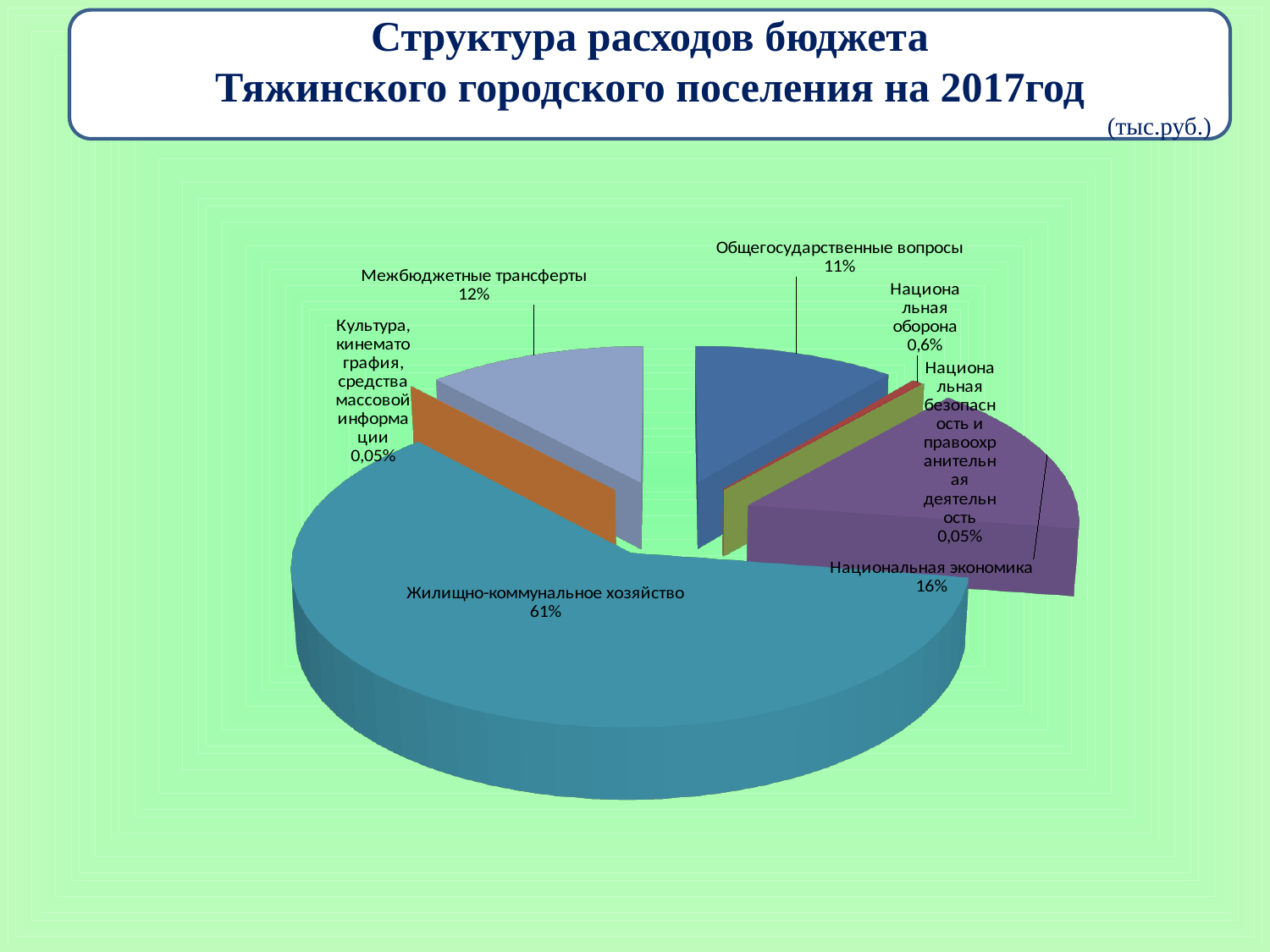
What share of the budget expenditure goes to Жилищно-коммунальное хозяйство? 61% Which category has the largest share of the budget expenditure? Жилищно-коммунальное хозяйство What share of the budget expenditure goes to Межбюджетные трансферты? 12% What is the difference in percentage points between the share for Жилищно-коммунальное хозяйство and the share for Национальная экономика? 45 Which is larger: the share for Национальная экономика or the share for Межбюджетные трансферты? Национальная экономика How many categories (slices) does the pie chart show? 7 What share of the budget expenditure goes to Национальная оборона? 0,6% What year does the chart title say the budget expenditure structure is for? 2017 What kind of chart is shown on the slide? pie chart What is the difference in percentage points between the share for Межбюджетные трансферты and the share for Общегосударственные вопросы? 1